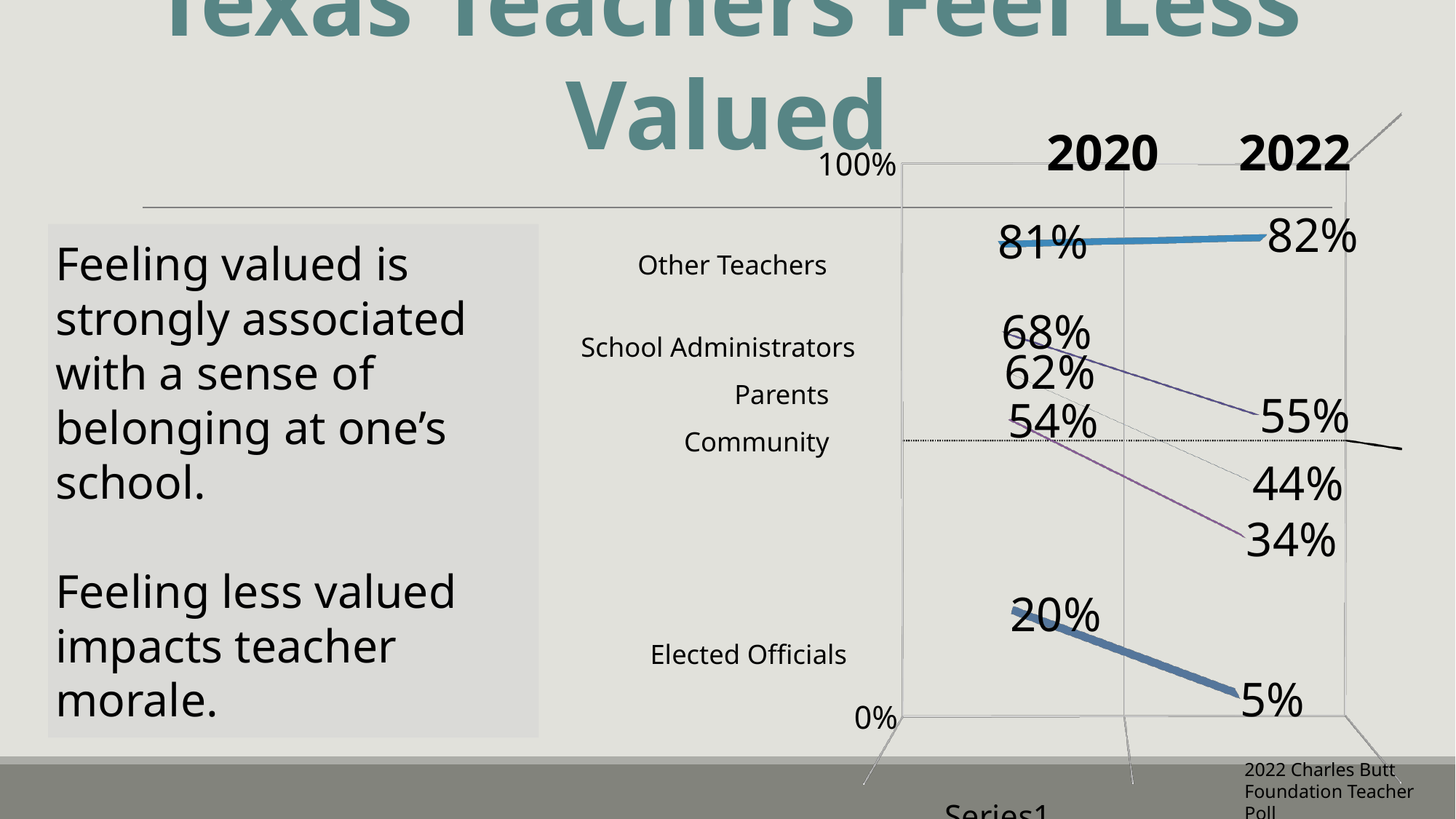
What was the value for Other Teachers in 2022? 82% Which group had the highest value in 2022? Other Teachers Which is larger: the 2020 value for School Administrators or the 2020 value for Parents? School Administrators Which group had the lowest value in 2020? Elected Officials What was the value for School Administrators in 2022? 55% What was the value for Elected Officials in 2020? 20% Did the value for Other Teachers rise or fall from 2020 to 2022? rise What kind of chart is shown on the slide? line chart What was the value for Elected Officials in 2022? 5% What was the value for Other Teachers in 2020? 81% By how many percentage points did the value for Elected Officials fall from 2020 to 2022? 15 How many groups (series) are plotted on the chart? 5